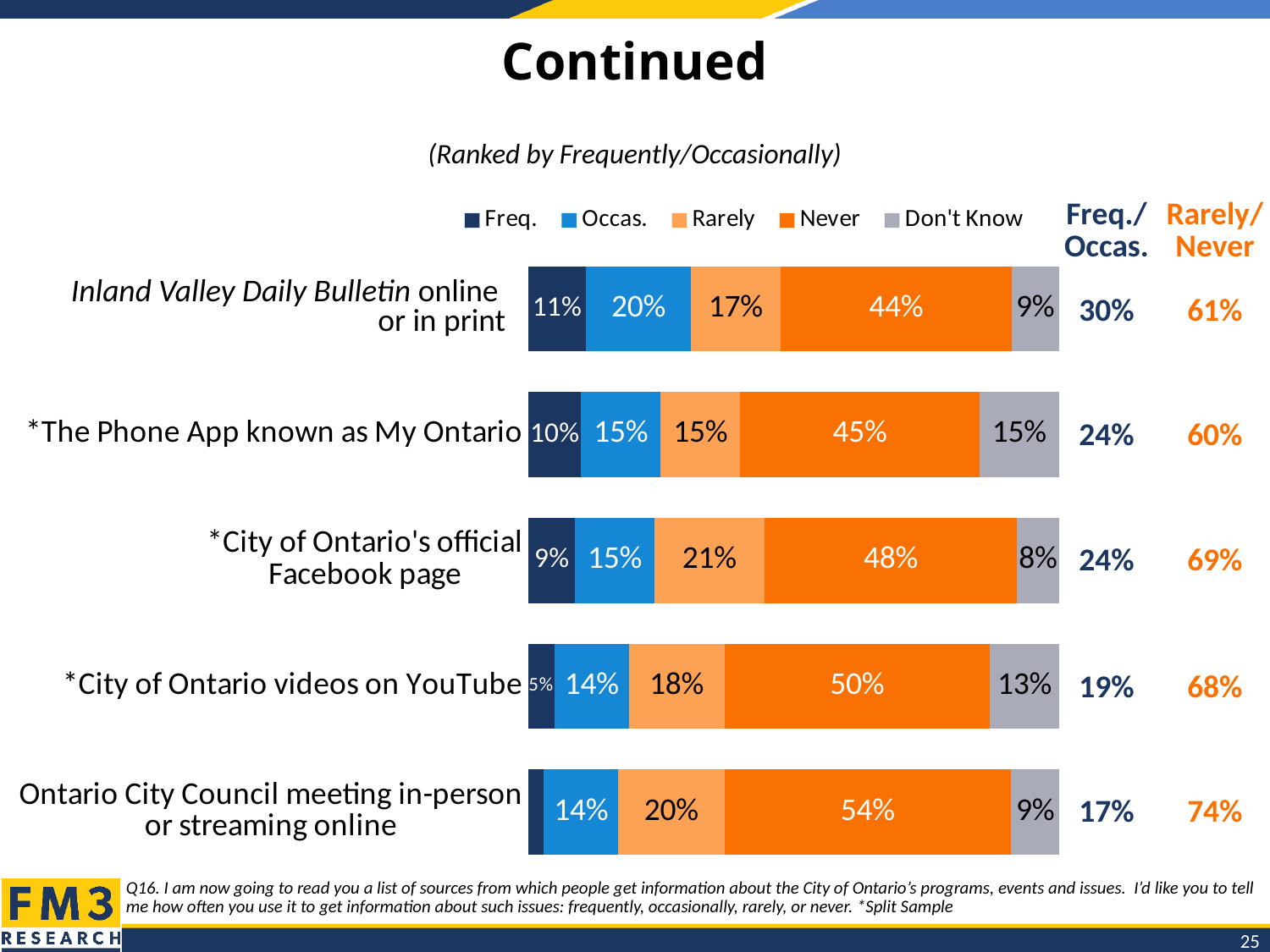
What is the difference between the "Never" values for Ontario City Council meeting and the Inland Valley Daily Bulletin? 10% What is the combined Freq./Occas. percentage shown for the Inland Valley Daily Bulletin online or in print? 30% What is the "Occas." value for the Phone App known as My Ontario? 15% How many series does the legend list? 5 What is the "Rarely" value for the City of Ontario's official Facebook page? 21% What percentage of respondents say they "Never" use the Inland Valley Daily Bulletin online or in print? 44% Which is larger: the "Rarely" value for the Phone App known as My Ontario or the "Rarely" value for City of Ontario videos on YouTube? City of Ontario videos on YouTube What kind of chart is shown on the slide? Stacked bar chart What is the "Don't Know" value for City of Ontario videos on YouTube? 13% Which source has the lowest "Freq." percentage among those with a printed Freq. label? City of Ontario videos on YouTube How many information sources are shown in the chart? 5 Which source has the highest "Never" percentage? Ontario City Council meeting in-person or streaming online